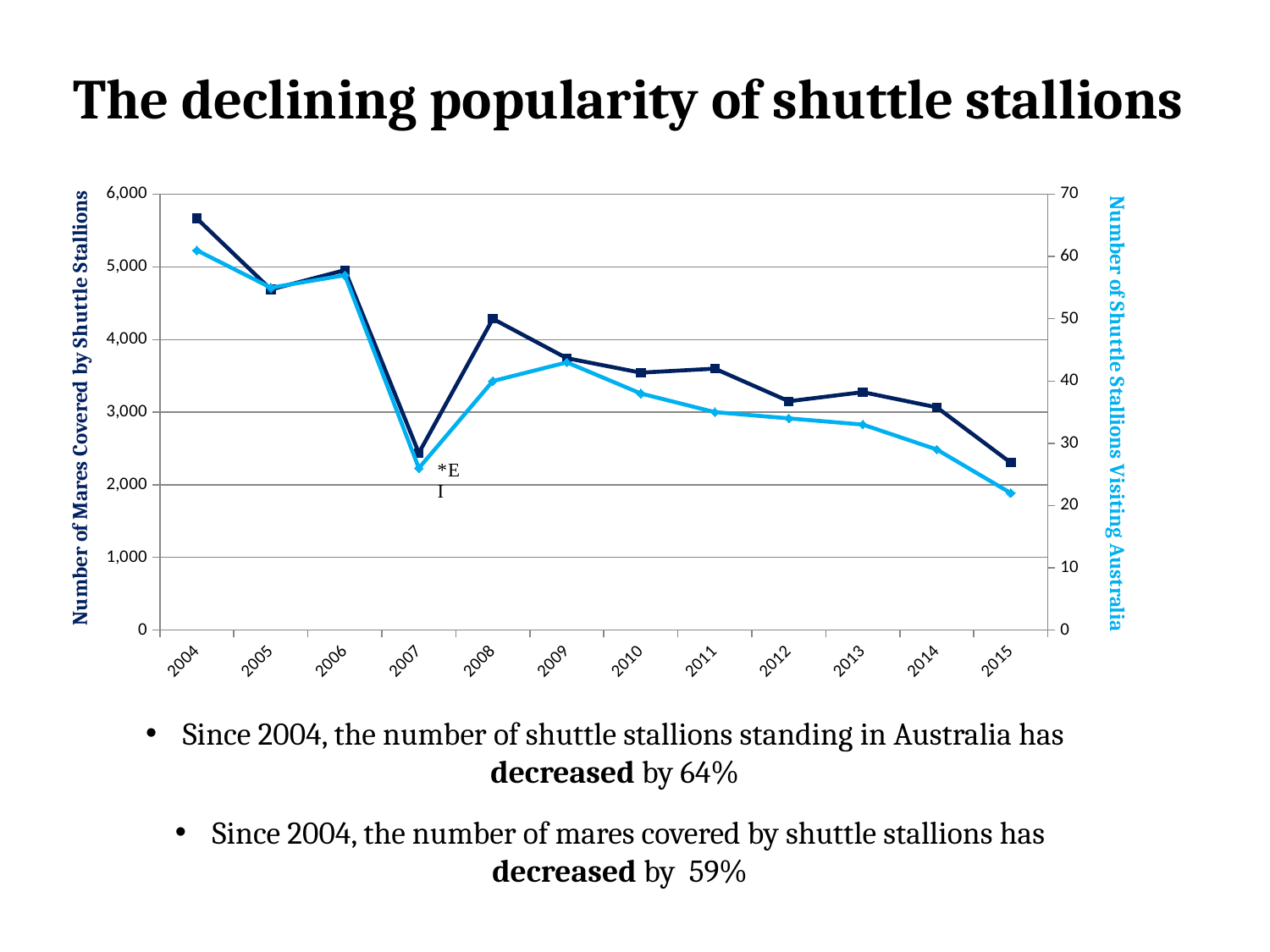
What kind of chart is shown on the slide? Line chart Overall, do the values of the dark blue line rise or fall from 2004 to 2015? Fall In which year is the number of shuttle stallions visiting Australia (light blue line) highest? 2004 Is the number of shuttle stallions visiting Australia in 2011 greater or less than 30? greater Is the number of mares covered by shuttle stallions in 2004 greater or less than 5,000? greater How many years are plotted along the x axis of the chart? 12 For the dark blue line, which year has the larger value, 2008 or 2010? 2008 In which year is the number of mares covered by shuttle stallions (dark blue line) highest? 2004 Is the number of shuttle stallions visiting Australia in 2007 greater or less than 30? less What is the title of the right vertical axis? Number of Shuttle Stallions Visiting Australia What is the title of the left vertical axis? Number of Mares Covered by Shuttle Stallions